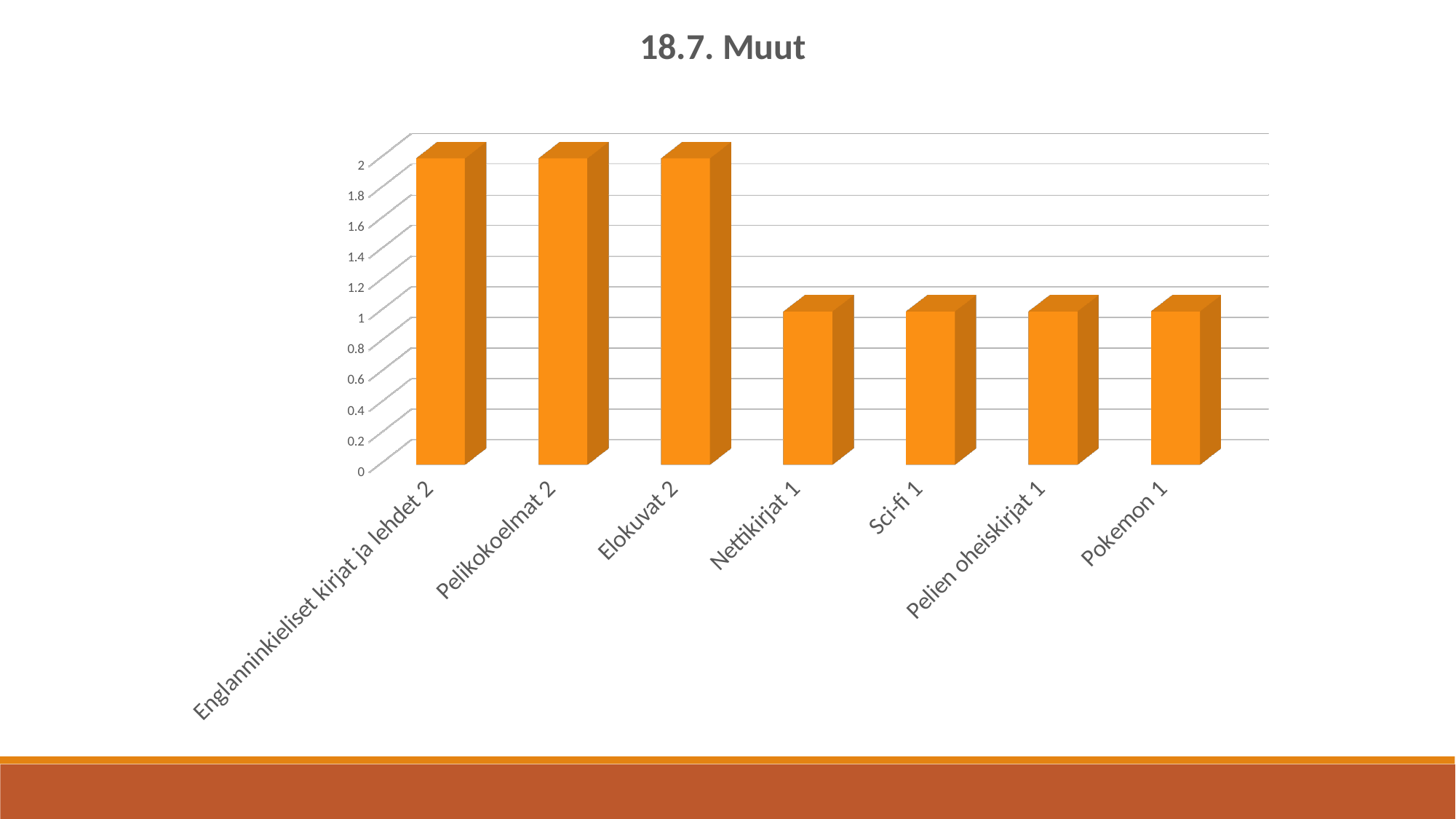
Do the values rise or fall moving from left to right along the x axis? fall What is the value for Nettikirjat? 1 What is the difference between the value for Elokuvat and the value for Pelien oheiskirjat? 1 What is the value for Elokuvat? 2 What is the value for Englanninkieliset kirjat ja lehdet? 2 What is the title of the chart? 18.7. Muut What is the value for Pokemon? 1 Is the value for Pelikokoelmat greater or less than 1.4? greater How many categories are shown in the chart? 7 Which is larger, the value for Pelikokoelmat or the value for Sci-fi? Pelikokoelmat What kind of chart is shown on the slide? bar chart Is the value for Sci-fi greater or less than 1.6? less